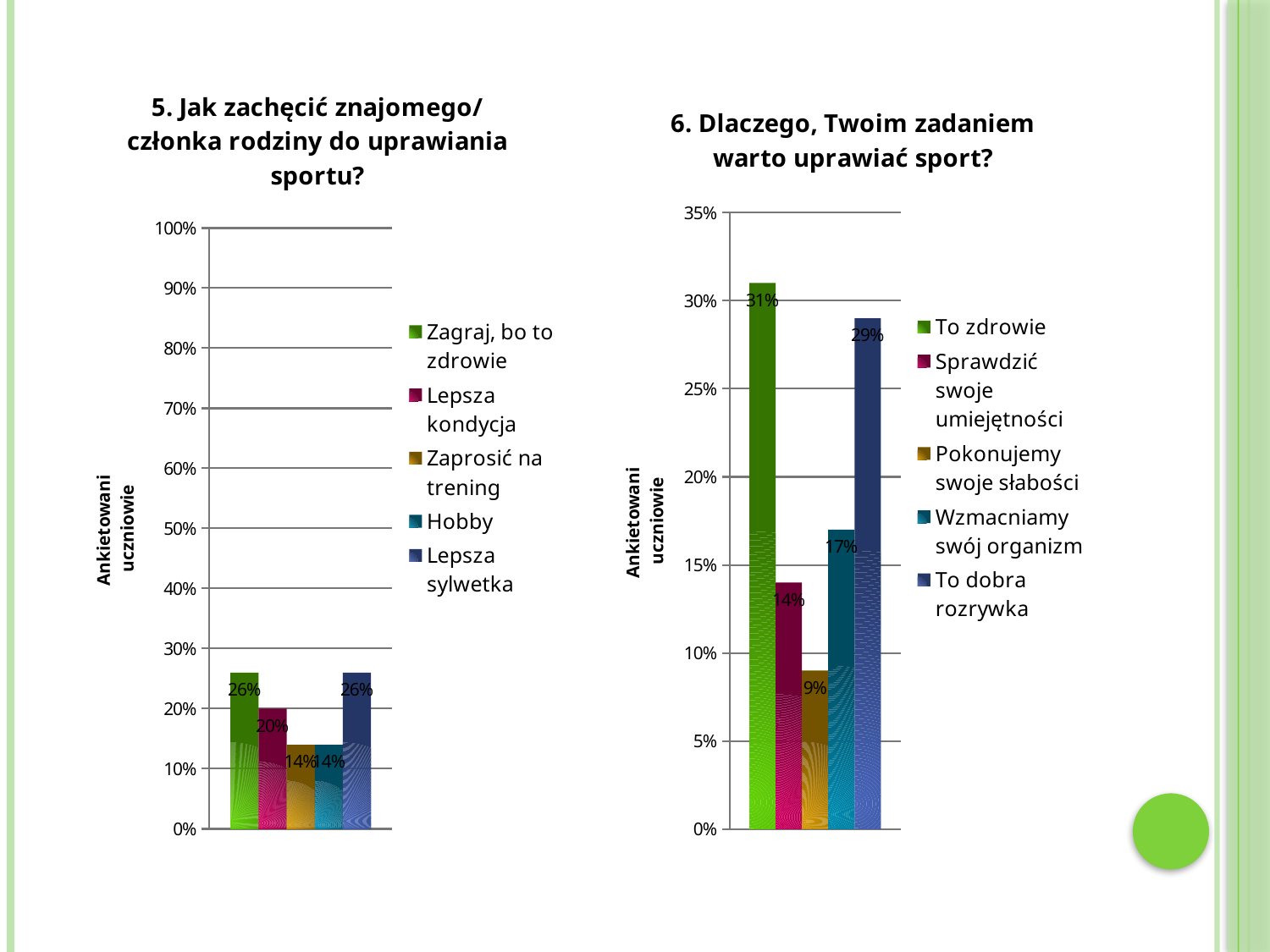
In the chart titled "6. Dlaczego, Twoim zadaniem warto uprawiać sport?", which series has the highest value? To zdrowie In the chart titled "6. Dlaczego, Twoim zadaniem warto uprawiać sport?", is the value for "Sprawdzić swoje umiejętności" greater or less than 15%? less In the chart titled "5. Jak zachęcić znajomego/członka rodziny do uprawiania sportu?", what is the value for "Hobby"? 14% In the chart titled "5. Jak zachęcić znajomego/członka rodziny do uprawiania sportu?", what is the value for "Lepsza kondycja"? 20% What kind of chart is the chart titled "6. Dlaczego, Twoim zadaniem warto uprawiać sport?"? bar chart In the chart titled "6. Dlaczego, Twoim zadaniem warto uprawiać sport?", what is the difference between "To zdrowie" and "To dobra rozrywka"? 2% In the chart titled "5. Jak zachęcić znajomego/członka rodziny do uprawiania sportu?", which is larger, "Lepsza sylwetka" or "Lepsza kondycja"? Lepsza sylwetka In the chart titled "5. Jak zachęcić znajomego/członka rodziny do uprawiania sportu?", how many series does the legend list? 5 What is the y-axis label of the chart titled "5. Jak zachęcić znajomego/członka rodziny do uprawiania sportu?"? Ankietowani uczniowie In the chart titled "6. Dlaczego, Twoim zadaniem warto uprawiać sport?", which series has the lowest value? Pokonujemy swoje słabości In the chart titled "5. Jak zachęcić znajomego/członka rodziny do uprawiania sportu?", what is the difference between "Zagraj, bo to zdrowie" and "Zaprosić na trening"? 12% In the chart titled "6. Dlaczego, Twoim zadaniem warto uprawiać sport?", what is the value for "Wzmacniamy swój organizm"? 17%